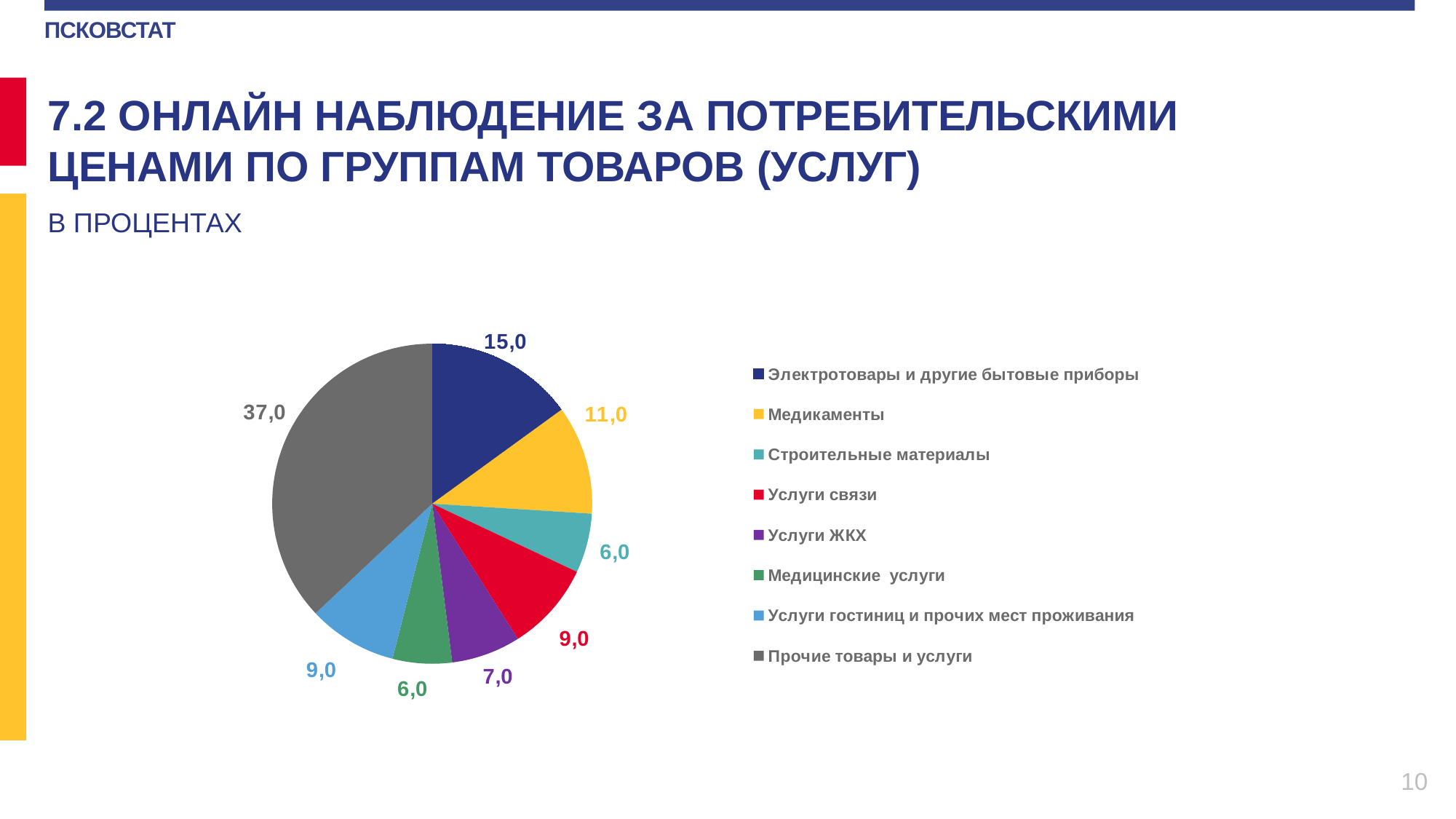
What is the value for Медикаменты? 11,0 What colour is the slice for Услуги связи? red What is the difference between the values for Услуги связи and Услуги ЖКХ? 2,0 How many categories does the legend list? 8 What type of chart is shown on the slide? pie chart Which is larger, the value for Медикаменты or the value for Услуги связи? Медикаменты What is the value for Электротовары и другие бытовые приборы? 15,0 Which category has the largest slice of the pie? Прочие товары и услуги What is the value for Прочие товары и услуги? 37,0 What share of the pie does Электротовары и другие бытовые приборы represent? 15,0% What is the value for Услуги ЖКХ? 7,0 What is the difference between the values for Прочие товары и услуги and Электротовары и другие бытовые приборы? 22,0